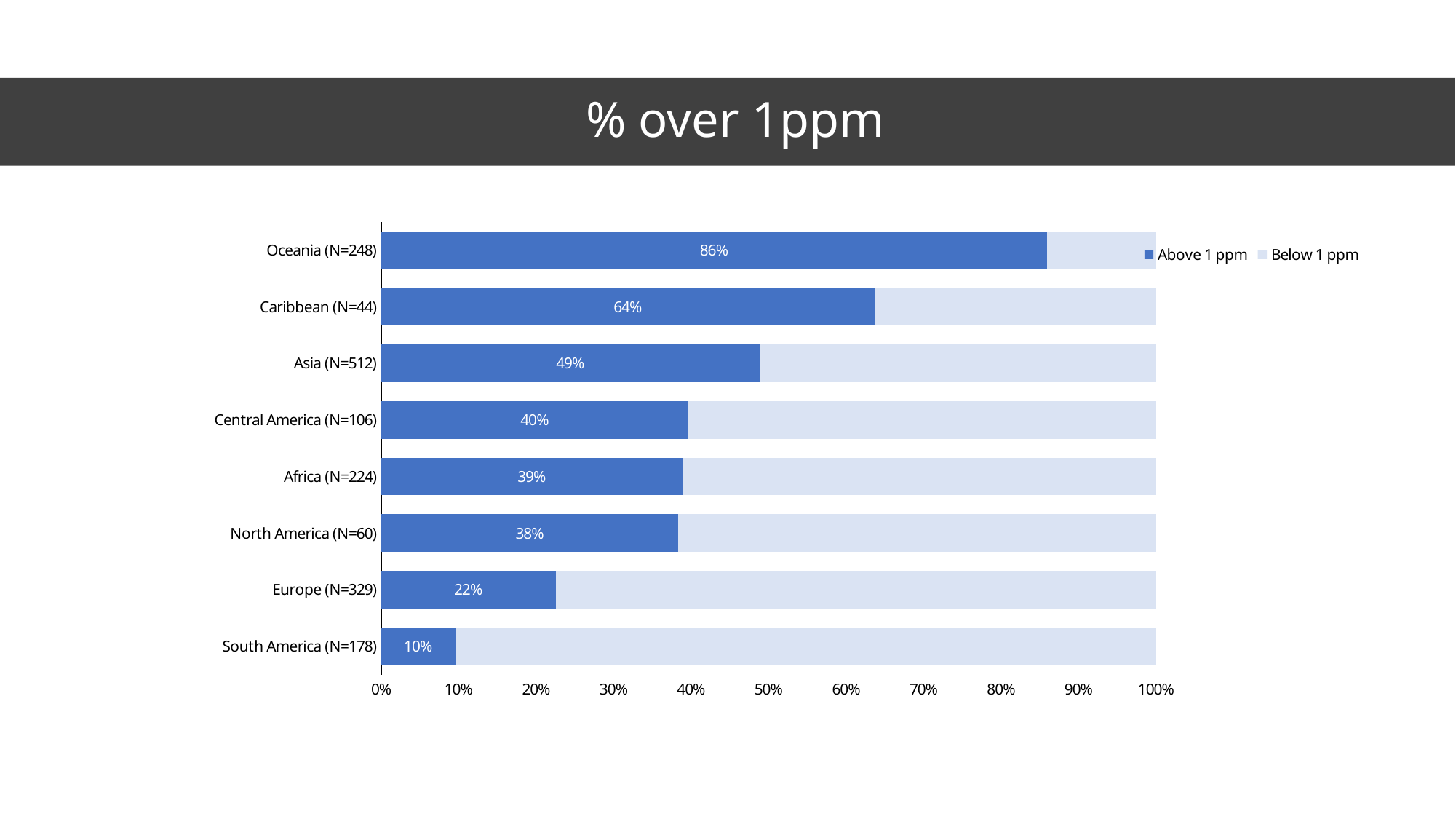
What is the difference between the Above 1 ppm values for Caribbean (N=44) and Central America (N=106)? 24% What is the Above 1 ppm value for Europe (N=329)? 22% Which region has the lowest Above 1 ppm value? South America (N=178) Which has a larger Above 1 ppm value, Asia (N=512) or North America (N=60)? Asia (N=512) Which region has the highest Above 1 ppm value? Oceania (N=248) What is the Above 1 ppm value for Oceania (N=248)? 86% Is the Below 1 ppm value for Europe (N=329) greater or less than 70%? greater What is the title of the slide? % over 1ppm How many series does the legend list? 2 What kind of chart is shown on the slide? Stacked bar chart How many regions are shown on the chart? 8 What is the Above 1 ppm value for Asia (N=512)? 49%